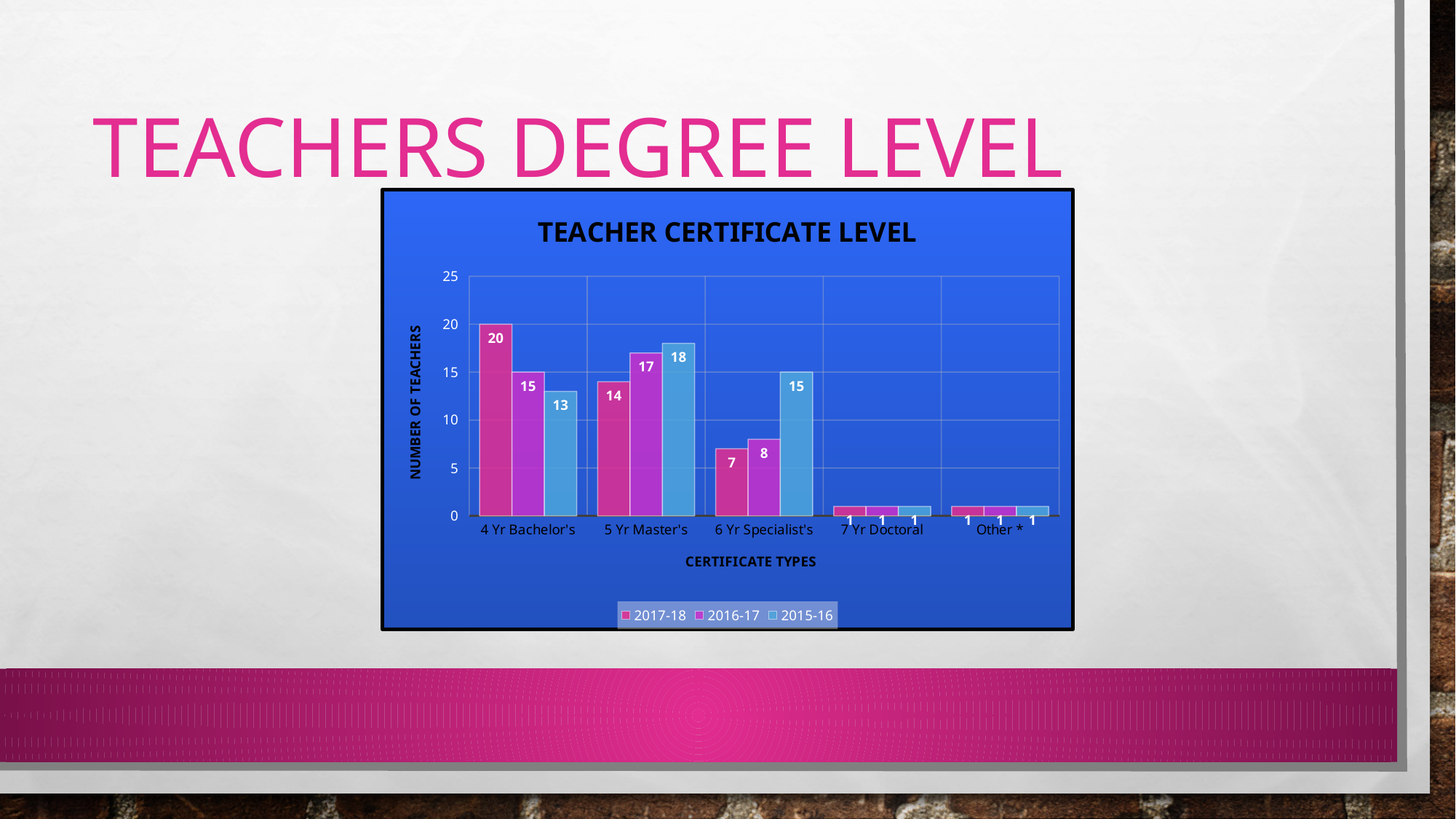
What is the number of teachers with a 5 Yr Master's in 2015-16? 18 What kind of chart is shown on the slide? Bar chart Which certificate type has the highest number of teachers in 2015-16? 5 Yr Master's What is the number of teachers with a 4 Yr Bachelor's in 2017-18? 20 Which certificate type has the highest number of teachers in 2017-18? 4 Yr Bachelor's Which is larger for 5 Yr Master's: the 2016-17 value or the 2017-18 value? 2016-17 What is the difference between the 2017-18 and 2015-16 values for 4 Yr Bachelor's? 7 What is the title of the chart? TEACHER CERTIFICATE LEVEL How many series does the legend list? 3 How many certificate types are shown on the x axis? 5 What is the difference between the 2015-16 and 2017-18 values for 6 Yr Specialist's? 8 What is the number of teachers with a 6 Yr Specialist's in 2016-17? 8